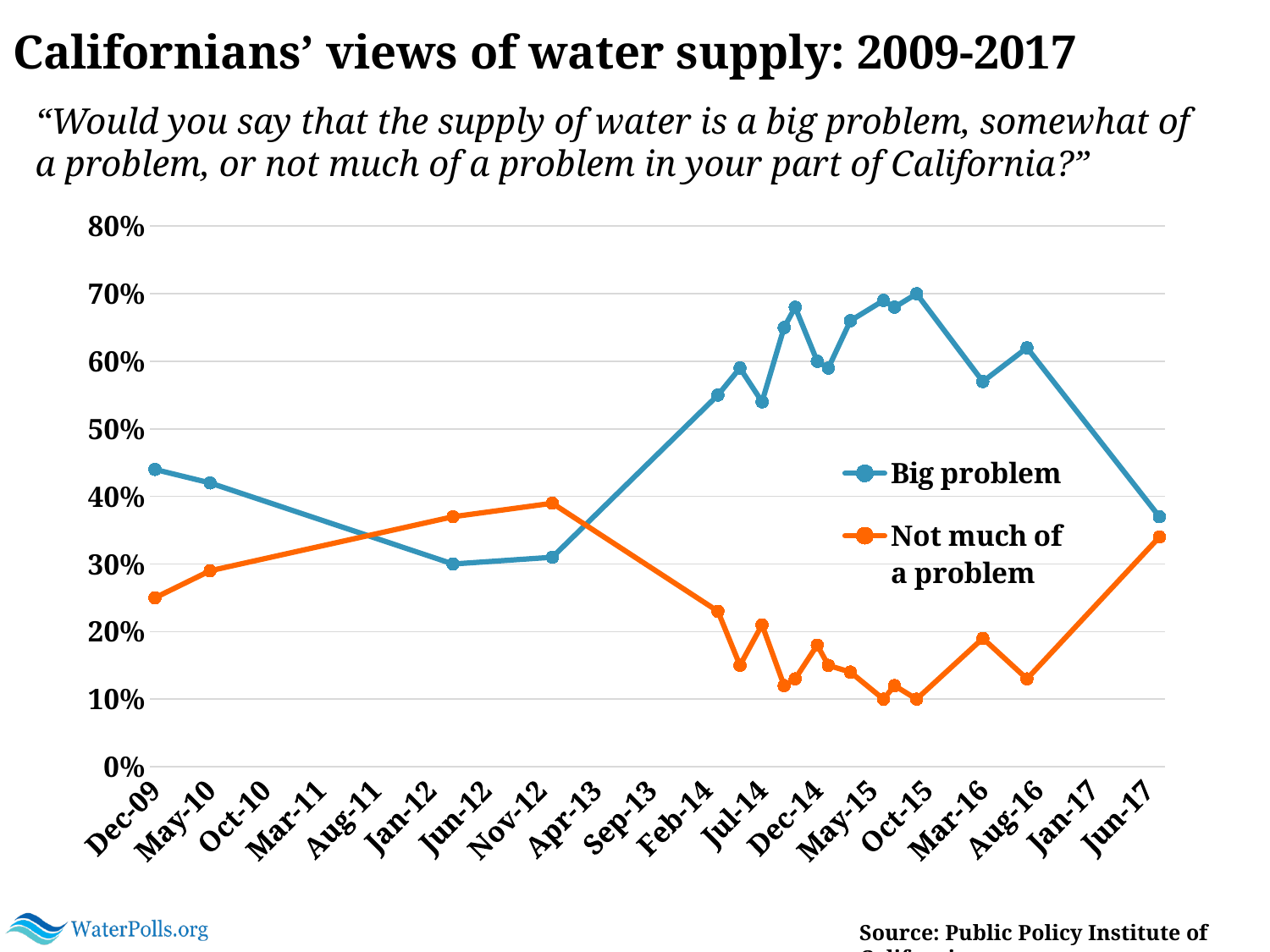
At Nov-12, which series has the higher value, Big problem or Not much of a problem? Not much of a problem Does the Not much of a problem line rise or fall from Dec-09 to Nov-12? Rise How many series does the legend list? 2 At Dec-09, which series has the higher value, Big problem or Not much of a problem? Big problem What kind of chart is shown on the slide? Line chart Is the value for Not much of a problem at Dec-09 greater or less than 30%? less What is the title of the chart? Californians' views of water supply: 2009-2017 Does the Big problem line rise or fall from Dec-09 to Jan-12? Fall Is the value for Big problem at Oct-15 greater or less than 60%? greater Is the value for Not much of a problem at Aug-16 greater or less than 20%? less What are the two series named in the legend? Big problem; Not much of a problem